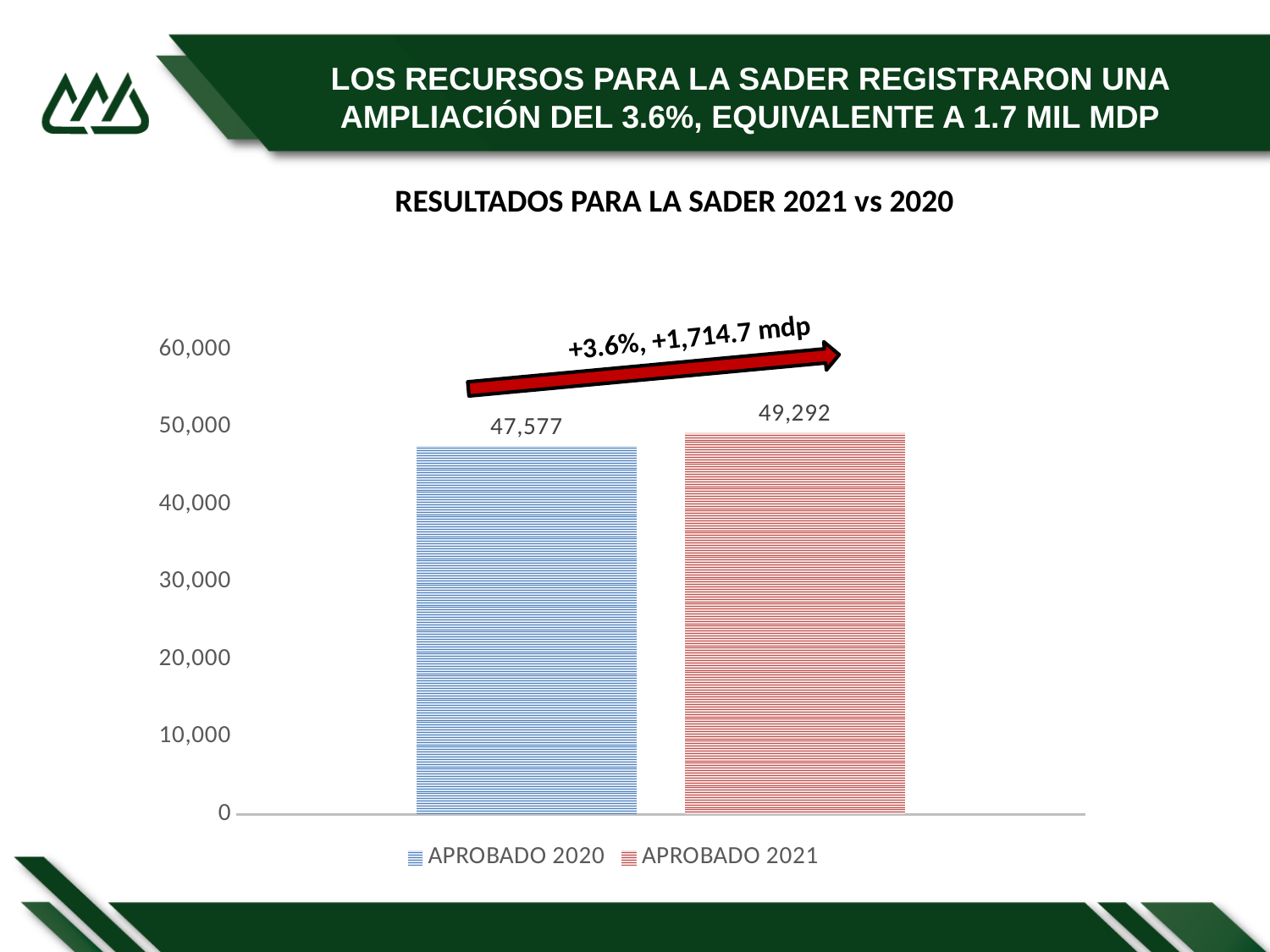
Is the value for APROBADO 2020 greater or less than 50,000? less What is the title of the chart? RESULTADOS PARA LA SADER 2021 vs 2020 What is the difference between the APROBADO 2021 and APROBADO 2020 values? 1,715 Which bar is the lowest? APROBADO 2020 Is the value for APROBADO 2021 greater or less than 40,000? greater How many bars are plotted in the chart? 2 What kind of chart is shown? bar chart What percentage change is annotated on the arrow above the bars? +3.6% What is the value for APROBADO 2021? 49,292 How many series does the legend list? 2 Which series has the higher value, APROBADO 2020 or APROBADO 2021? APROBADO 2021 What is the value for APROBADO 2020? 47,577